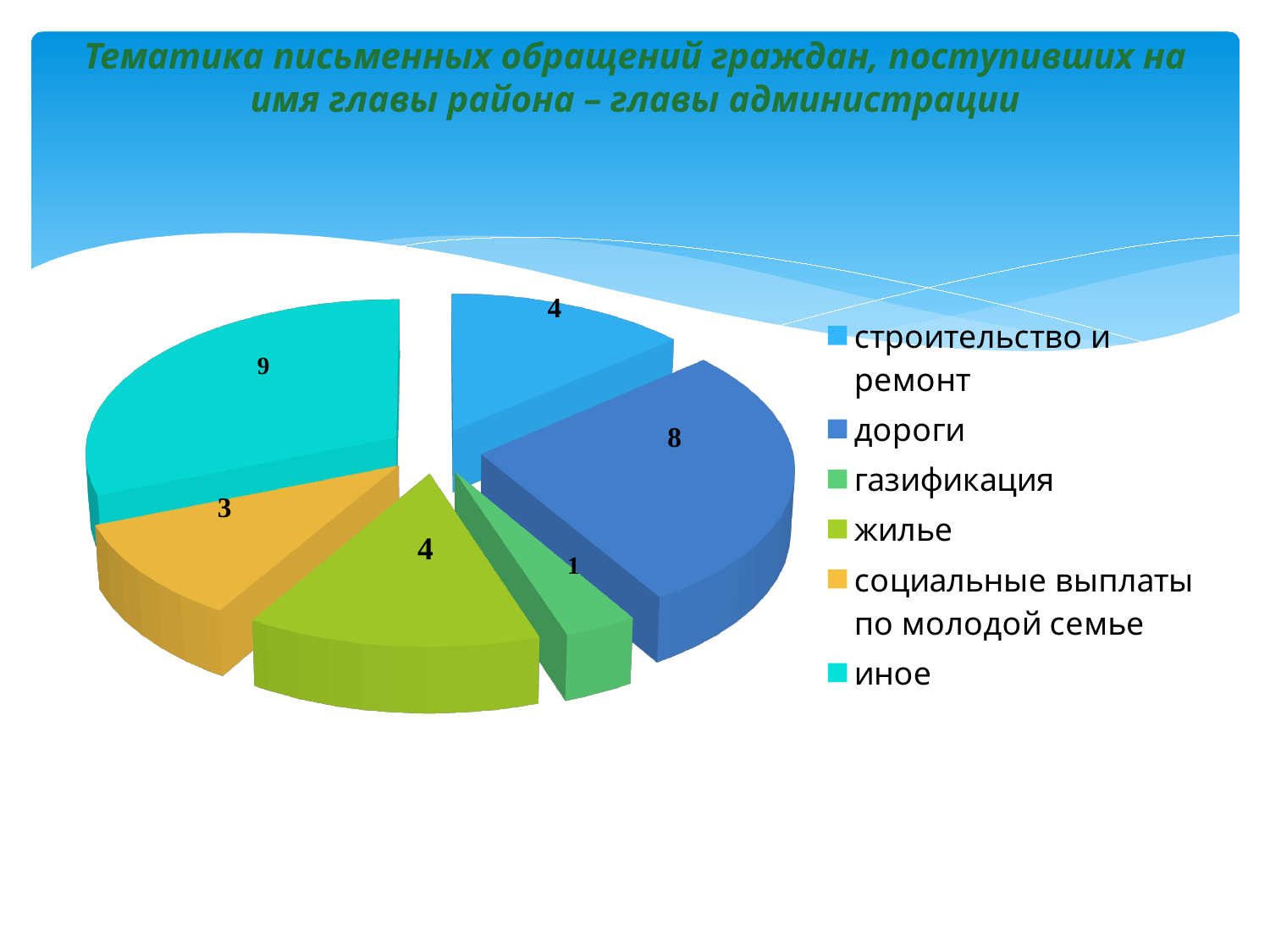
What is the value for социальные выплаты по молодой семье? 3 How many categories does the pie chart have? 6 Which legend entry is shown in yellow-orange? социальные выплаты по молодой семье Which category has the largest slice? иное What is the difference between the values for иное and дороги? 1 What is the value for иное? 9 What is the value for газификация? 1 What is the total of all the values shown in the pie chart? 29 Which is larger, the value for жилье or the value for социальные выплаты по молодой семье? жилье Which category has the smallest slice? газификация What kind of chart is shown on the slide? pie chart What is the value for дороги? 8